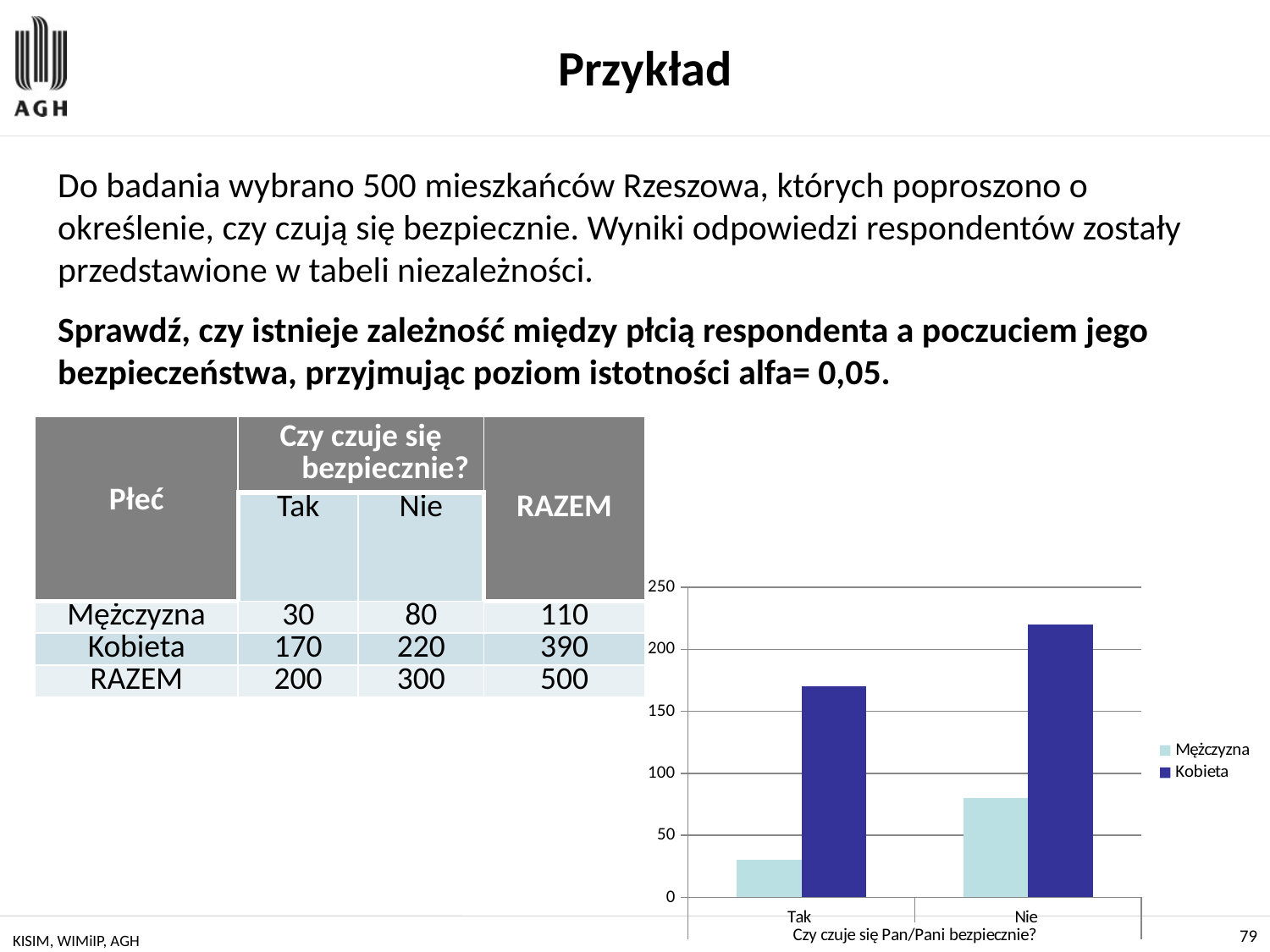
Is the value for Mężczyzna in the Nie category greater or less than 100? less How many series does the chart's legend list? 2 Which series and category has the shortest bar in the chart? Mężczyzna, Tak Is the value for Kobieta in the Nie category greater or less than 200? greater In the Tak category, which series has the larger bar, Mężczyzna or Kobieta? Kobieta For the Kobieta series, which category has the larger bar, Tak or Nie? Nie Which series and category has the tallest bar in the chart? Kobieta, Nie Is the value for Kobieta in the Tak category greater or less than 150? greater What is the x-axis title of the chart? Czy czuje się Pan/Pani bezpiecznie? How many categories are shown on the x axis of the chart? 2 What kind of chart is shown on the slide? bar chart